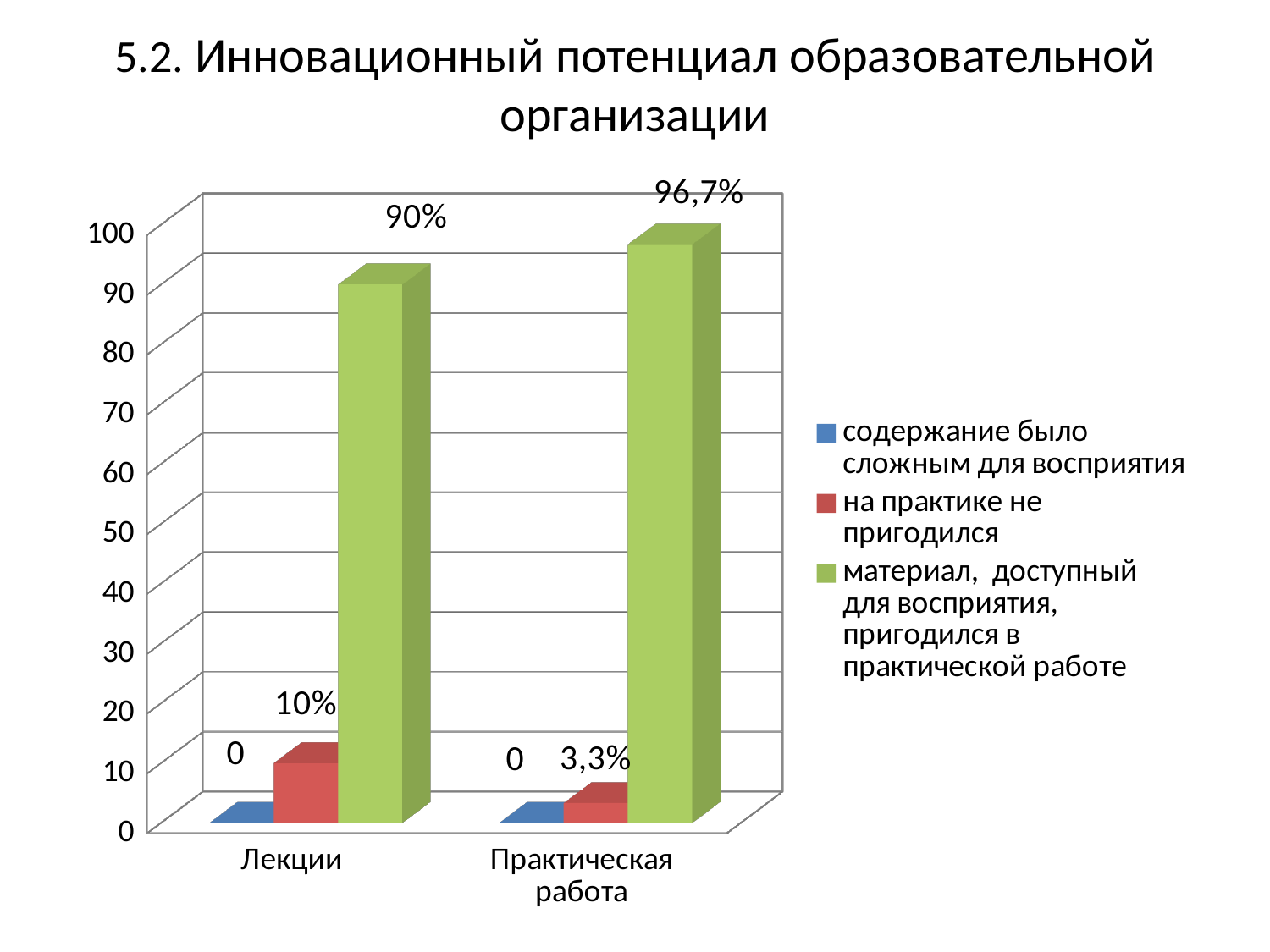
Which series has the lowest value in the "Практическая работа" category? содержание было сложным для восприятия What is the value for "на практике не пригодился" in the "Практическая работа" category? 3,3% What is the value for "на практике не пригодился" in the "Лекции" category? 10% How many categories are shown on the x axis? 2 What kind of chart is shown on the slide? bar chart How many series does the legend list? 3 What is the value for "материал, доступный для восприятия, пригодился в практической работе" in the "Лекции" category? 90% What is the value for "содержание было сложным для восприятия" in the "Лекции" category? 0 What is the value for "материал, доступный для восприятия, пригодился в практической работе" in the "Практическая работа" category? 96,7% What colour are the bars for "на практике не пригодился"? red Which category has the higher value for "материал, доступный для восприятия, пригодился в практической работе"? Практическая работа What is the difference between the "на практике не пригодился" values for "Лекции" and "Практическая работа"? 6,7%